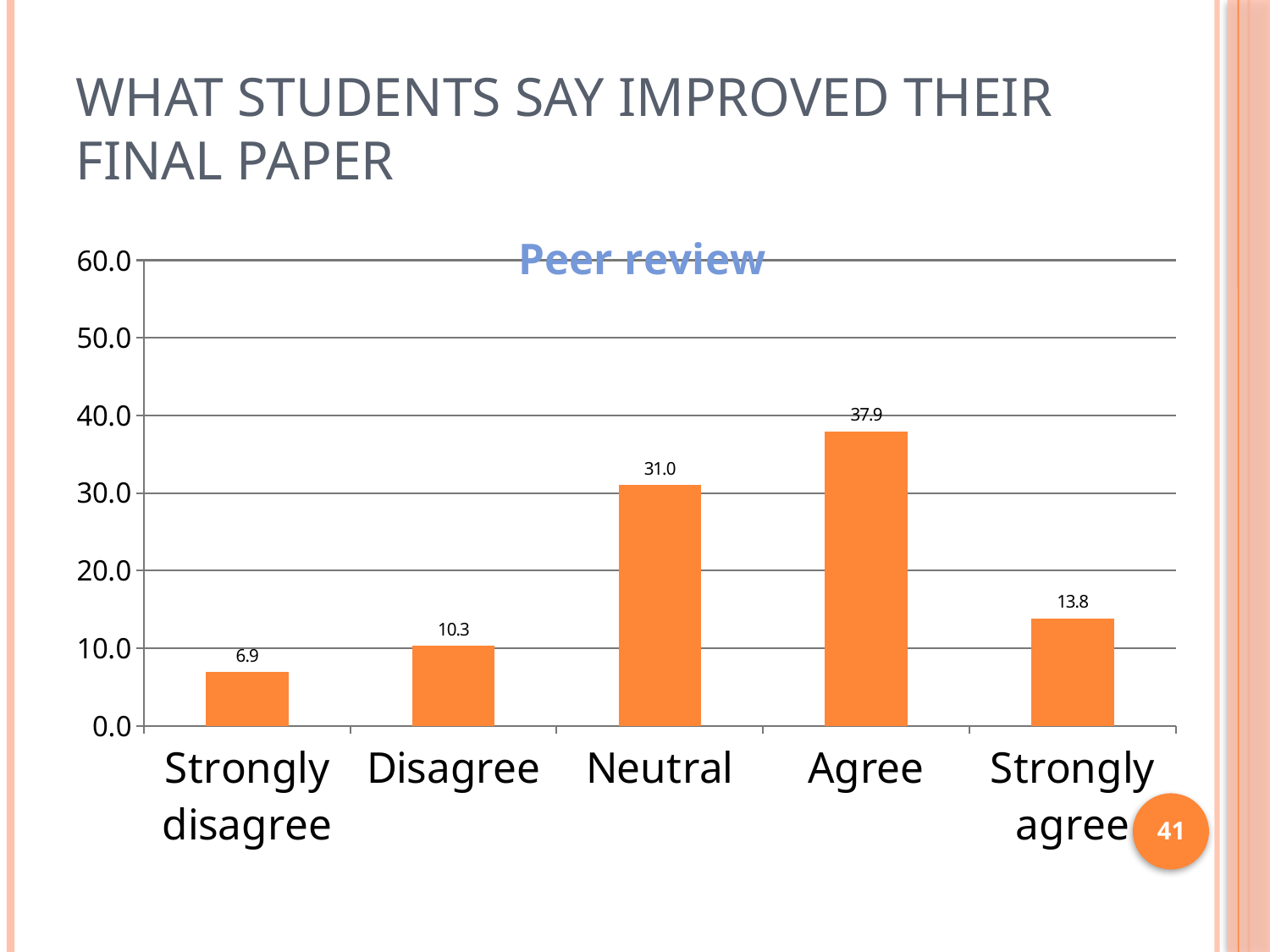
Which category has the highest value? Agree Which is larger, the value for Disagree or the value for Strongly agree? Strongly agree Which category has the lowest value? Strongly disagree What kind of chart is shown? Bar chart What is the value for Strongly agree? 13.8 What is the difference between the values for Agree and Neutral? 6.9 What is the value for Neutral? 31.0 What is the difference between the values for Strongly agree and Disagree? 3.5 What is the value for Strongly disagree? 6.9 What is the title of the chart? Peer review What is the value for Agree? 37.9 How many categories are shown on the x axis? 5